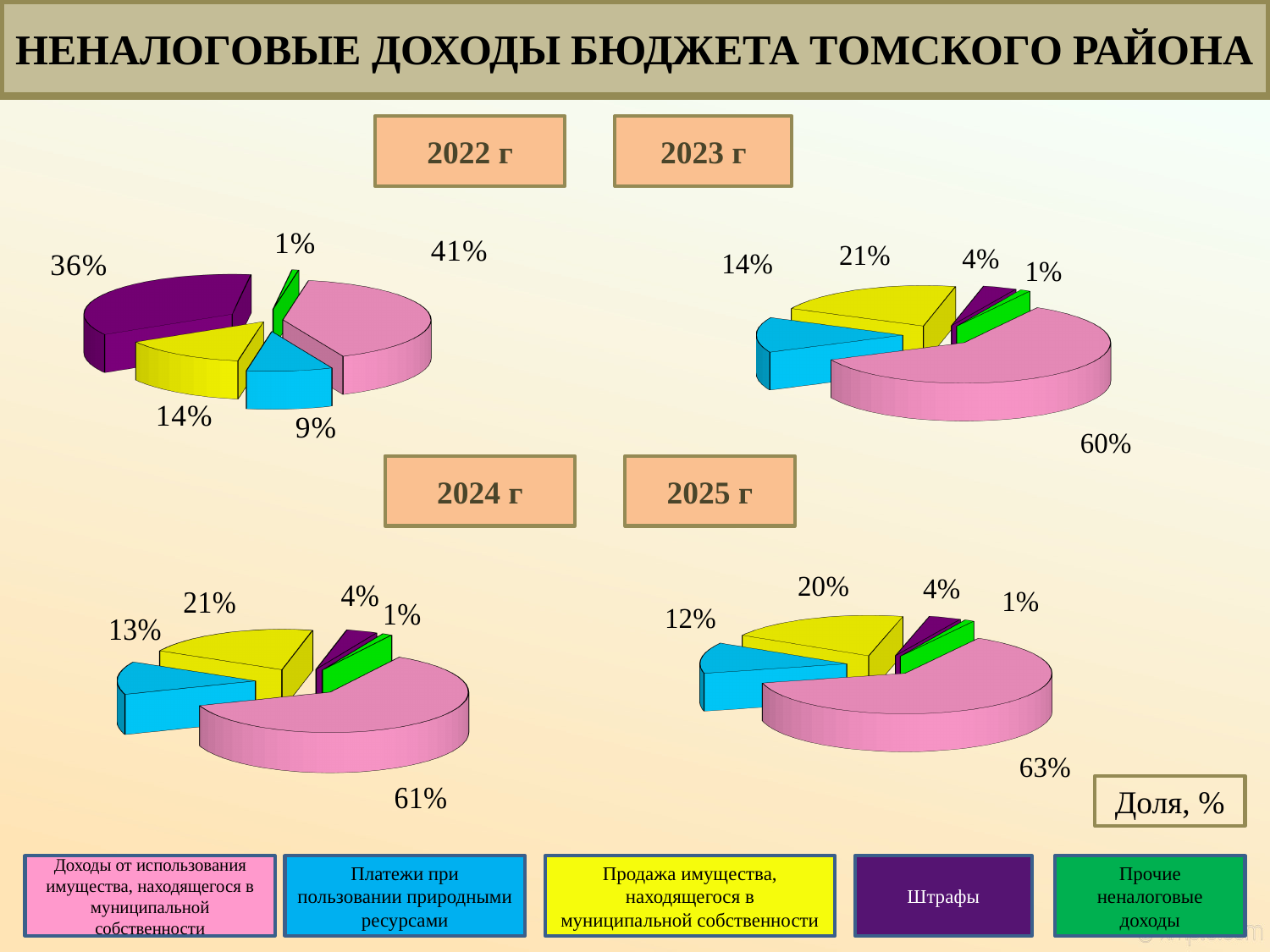
In the 2025 г pie chart, which is larger: the share of Платежи при пользовании природными ресурсами or the share of Продажа имущества, находящегося в муниципальной собственности? Продажа имущества, находящегося в муниципальной собственности How many pie charts are shown on the slide? 4 In the 2022 г pie chart, what share is shown for Штрафы (purple slice)? 36% In the 2022 г pie chart, which category has the smallest share? Прочие неналоговые доходы In the 2022 г pie chart, what is the difference between the shares of Доходы от использования имущества (41%) and Штрафы (36%)? 5% In the 2024 г pie chart, what share is shown for Продажа имущества, находящегося в муниципальной собственности (yellow slice)? 21% In the 2023 г pie chart, what share is shown for Платежи при пользовании природными ресурсами (blue slice)? 14% In the 2023 г pie chart, which category has the largest share? Доходы от использования имущества, находящегося в муниципальной собственности What type of chart is used for the 2024 г data? Pie chart How many categories does the legend at the bottom of the slide list? 5 In the 2022 г pie chart, what share is shown for Доходы от использования имущества, находящегося в муниципальной собственности (pink slice)? 41% In the 2025 г pie chart, what share is shown for Доходы от использования имущества, находящегося в муниципальной собственности (pink slice)? 63%